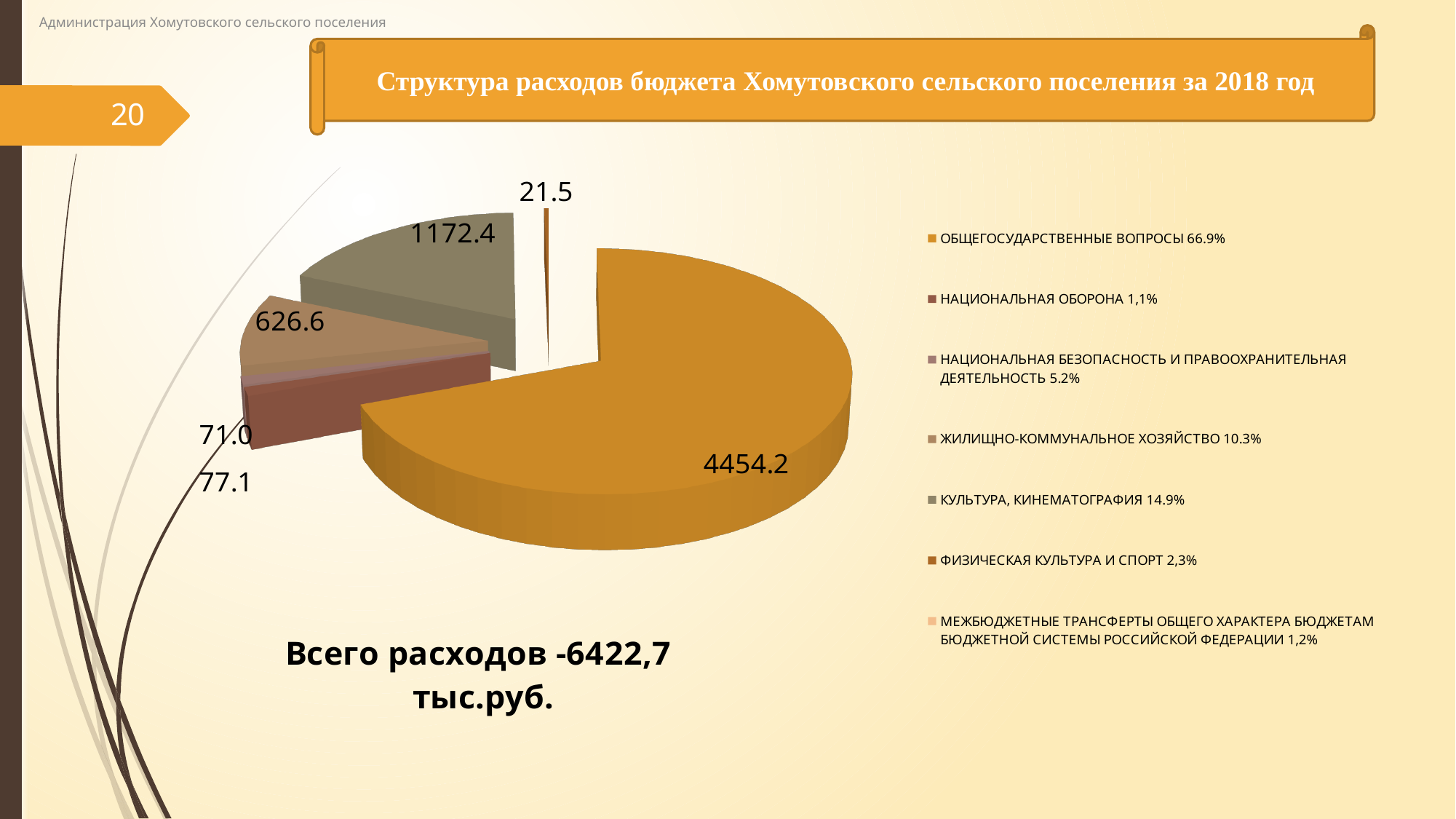
How many categories does the legend of the pie chart list? 7 What kind of chart is shown on the slide? pie chart What total expenditure amount is stated below the pie chart? 6422,7 тыс.руб. What percentage does the legend give for ОБЩЕГОСУДАРСТВЕННЫЕ ВОПРОСЫ? 66.9% What value is labelled on the largest slice (ОБЩЕГОСУДАРСТВЕННЫЕ ВОПРОСЫ)? 4454.2 Which category has the largest slice in the pie chart? ОБЩЕГОСУДАРСТВЕННЫЕ ВОПРОСЫ Which is larger: the КУЛЬТУРА, КИНЕМАТОГРАФИЯ slice or the ЖИЛИЩНО-КОММУНАЛЬНОЕ ХОЗЯЙСТВО slice? КУЛЬТУРА, КИНЕМАТОГРАФИЯ What value is labelled on the КУЛЬТУРА, КИНЕМАТОГРАФИЯ slice? 1172.4 What value is labelled on the ЖИЛИЩНО-КОММУНАЛЬНОЕ ХОЗЯЙСТВО slice? 626.6 What is the difference between the КУЛЬТУРА, КИНЕМАТОГРАФИЯ value (1172.4) and the ЖИЛИЩНО-КОММУНАЛЬНОЕ ХОЗЯЙСТВО value (626.6)? 545.8 What is the difference between the ОБЩЕГОСУДАРСТВЕННЫЕ ВОПРОСЫ value (4454.2) and the КУЛЬТУРА, КИНЕМАТОГРАФИЯ value (1172.4)? 3281.8 What is the smallest data label shown on the pie chart? 21.5